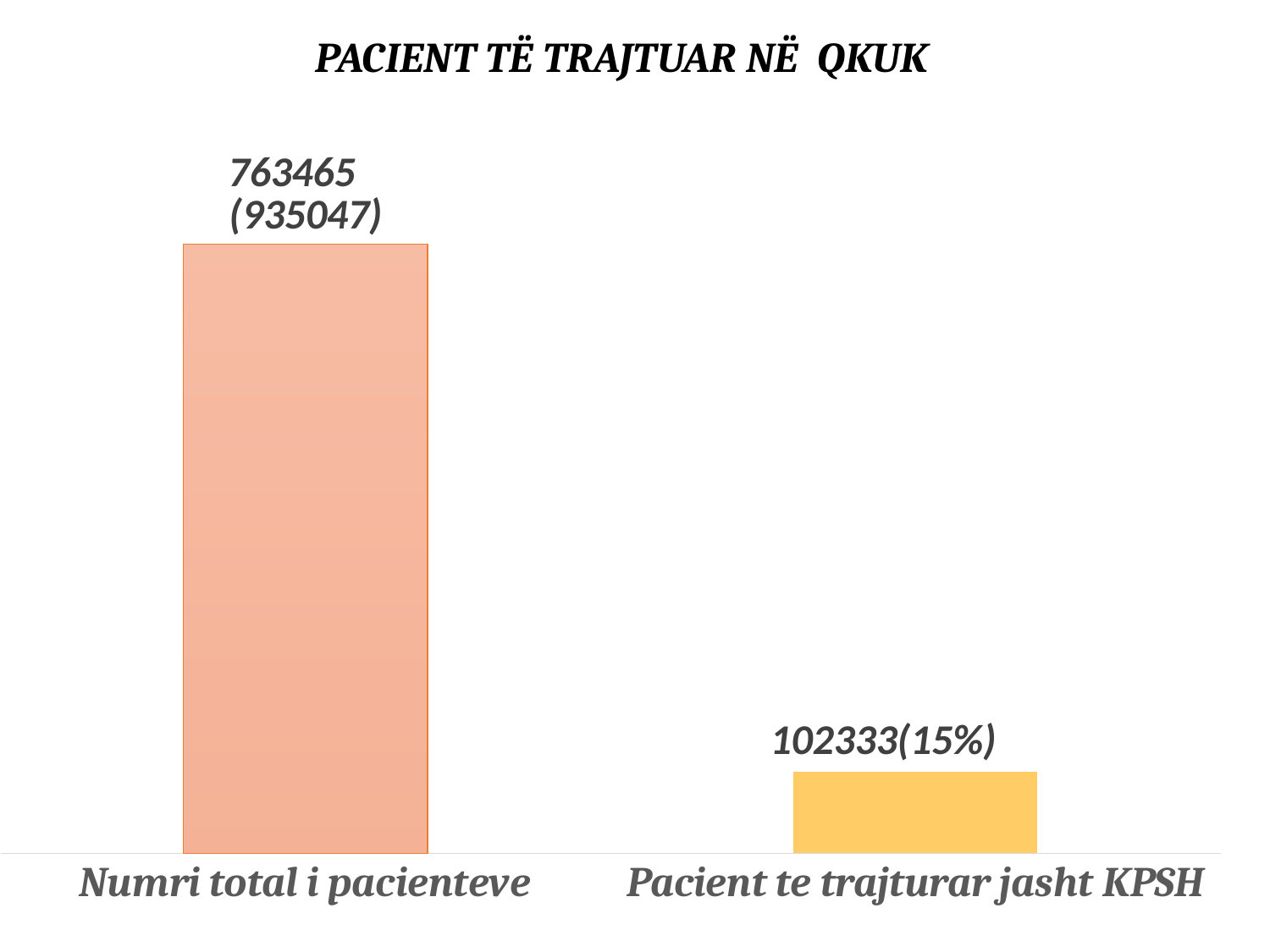
What kind of chart is shown on the slide? Bar chart Which is larger, the bar for "Numri total i pacienteve" or the bar for "Pacient te trajturar jasht KPSH"? Numri total i pacienteve What is the data label shown on the bar for "Numri total i pacienteve"? 763465 (935047) What is the difference between 763465 and 102333, the two main values shown on the bars? 661132 What percentage is shown in the label for "Pacient te trajturar jasht KPSH"? 15% Which category has the highest bar? Numri total i pacienteve What is the data label shown on the bar for "Pacient te trajturar jasht KPSH"? 102333(15%) Which category has the lowest bar? Pacient te trajturar jasht KPSH What colour is the bar for "Pacient te trajturar jasht KPSH"? Yellow What is the title of the chart? PACIENT TË TRAJTUAR NË QKUK How many categories are shown on the chart? 2